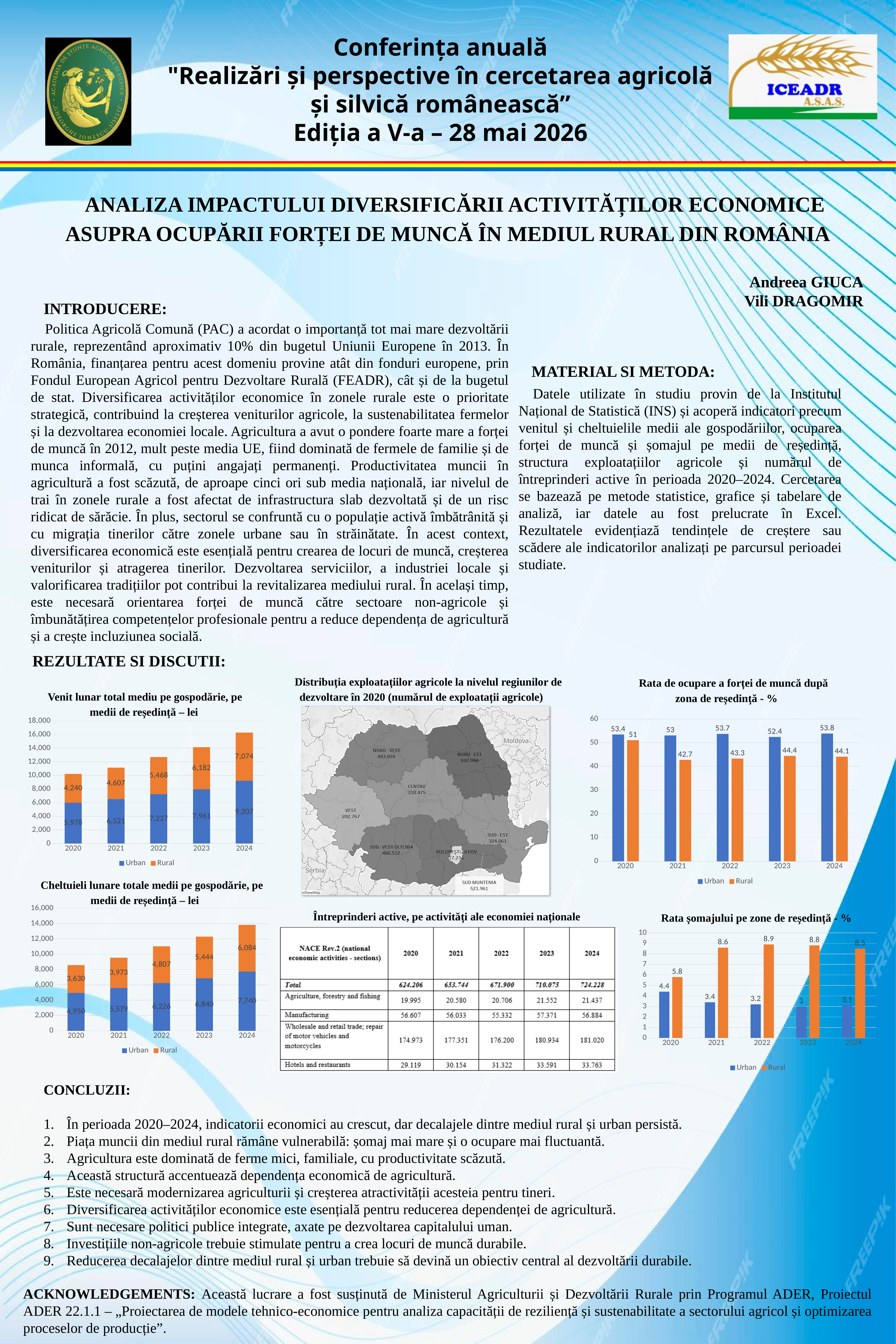
In the chart 'Venit lunar total mediu pe gospodărie, pe medii de reședință – lei', what is the total of the stacked bar for 2024? 16,281 In the chart 'Cheltuieli lunare totale medii pe gospodărie, pe medii de reședință – lei', how many series does the legend list? 2 In the chart 'Cheltuieli lunare totale medii pe gospodărie, pe medii de reședință – lei', what is the difference between the Urban and Rural values in 2024? 1,656 In the chart 'Rata șomajului pe zone de reședință - %', what is the Rural value for 2022? 8.9 In the chart 'Rata de ocupare a forței de muncă după zona de reședință - %', which year has the lowest Rural value? 2021 In the chart 'Cheltuieli lunare totale medii pe gospodărie, pe medii de reședință – lei', what is the Rural value for 2022? 4,807 In the chart 'Rata șomajului pe zone de reședință - %', which is larger in 2020, the Urban or the Rural value? Rural In the chart 'Venit lunar total mediu pe gospodărie, pe medii de reședință – lei', do the Rural values rise or fall from 2020 to 2024? rise In the chart 'Venit lunar total mediu pe gospodărie, pe medii de reședință – lei', what is the Urban value for 2024? 9,207 In the chart 'Rata de ocupare a forței de muncă după zona de reședință - %', which year has the highest Urban value? 2024 In the chart 'Rata de ocupare a forței de muncă după zona de reședință - %', what is the Rural value for 2021? 42.7 What kind of chart is 'Rata șomajului pe zone de reședință - %'? bar chart